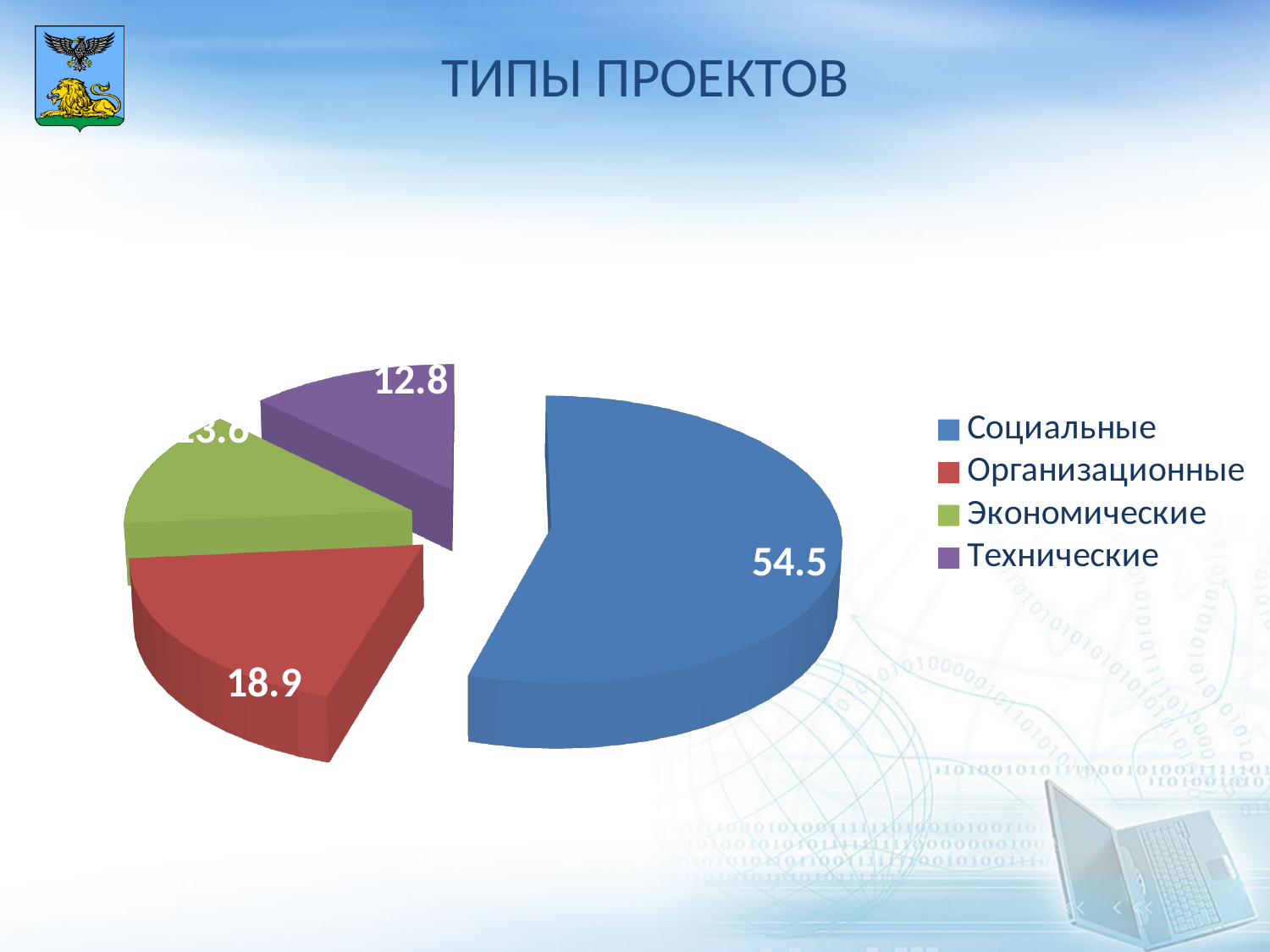
Which is larger, the value for Организационные or the value for Технические? Организационные Which category has the largest slice of the pie? Социальные How many categories does the pie chart show? 4 Which is larger, the value for Социальные or the value for Экономические? Социальные What is the title of the chart? ТИПЫ ПРОЕКТОВ What is the difference between the values for Организационные and Технические? 6.1 What colour is the Социальные slice? Blue What kind of chart is shown on the slide? Pie chart What value is shown for the Социальные slice? 54.5 What is the difference between the values for Социальные and Организационные? 35.6 What value is shown for the Организационные slice? 18.9 What value is shown for the Технические slice? 12.8